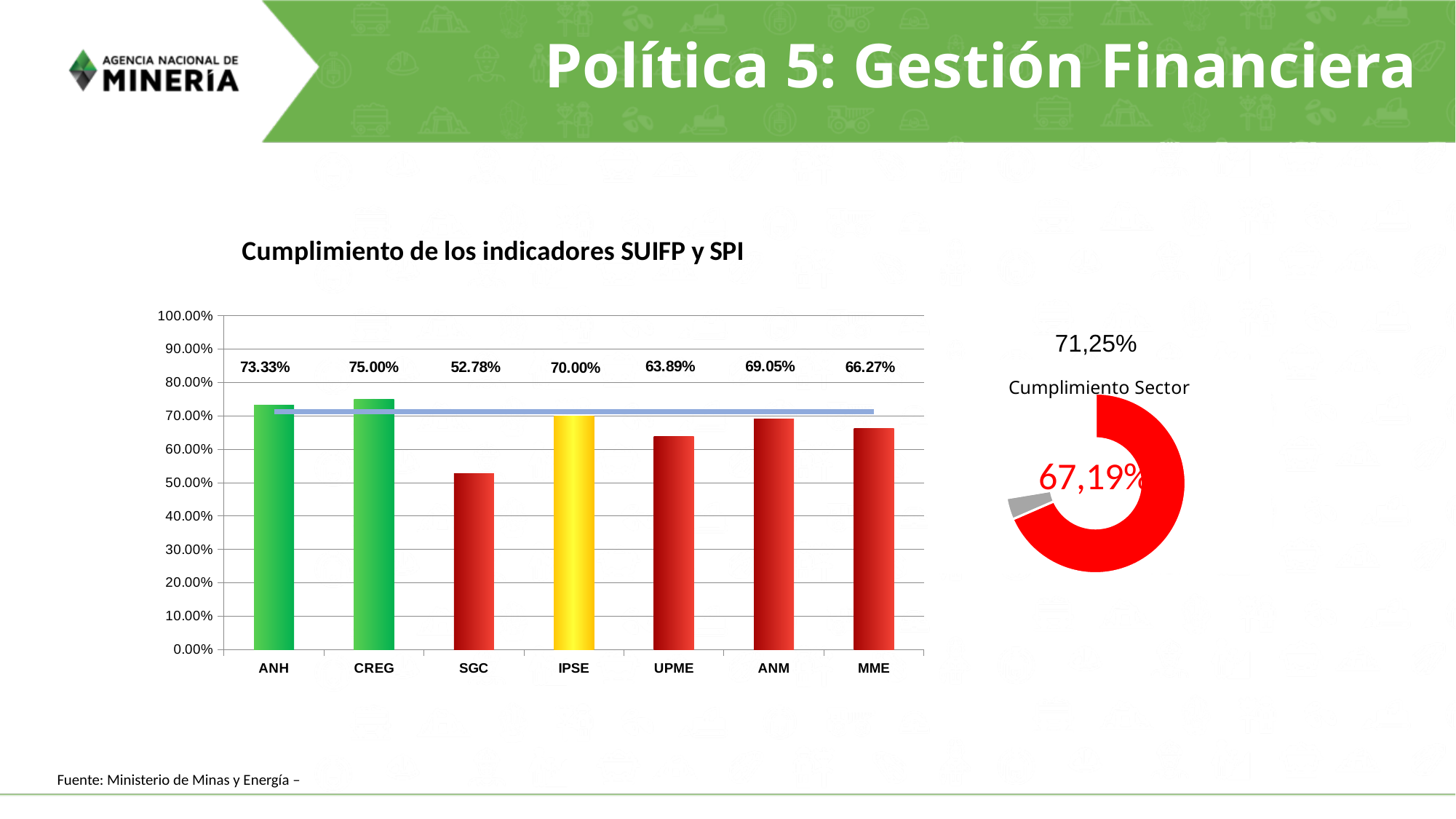
In the bar chart 'Cumplimiento de los indicadores SUIFP y SPI', is the value for IPSE greater or less than 60.00%? greater What value is printed above the label 'Cumplimiento Sector' on the right of the slide? 71,25% In the bar chart 'Cumplimiento de los indicadores SUIFP y SPI', what is the value for CREG? 75.00% In the bar chart 'Cumplimiento de los indicadores SUIFP y SPI', which is larger, the value for ANM or the value for MME? ANM In the bar chart 'Cumplimiento de los indicadores SUIFP y SPI', what is the difference between the values for CREG and SGC? 22.22% In the bar chart 'Cumplimiento de los indicadores SUIFP y SPI', what is the value for SGC? 52.78% What kind of chart is 'Cumplimiento de los indicadores SUIFP y SPI'? combination bar and line chart In the bar chart 'Cumplimiento de los indicadores SUIFP y SPI', which entity has the highest value? CREG In the bar chart 'Cumplimiento de los indicadores SUIFP y SPI', what is the value for UPME? 63.89% In the bar chart 'Cumplimiento de los indicadores SUIFP y SPI', which entity has the lowest value? SGC How many entities are shown on the x axis of the bar chart 'Cumplimiento de los indicadores SUIFP y SPI'? 7 In the donut chart on the right of the slide, what percentage is printed in the centre? 67,19%